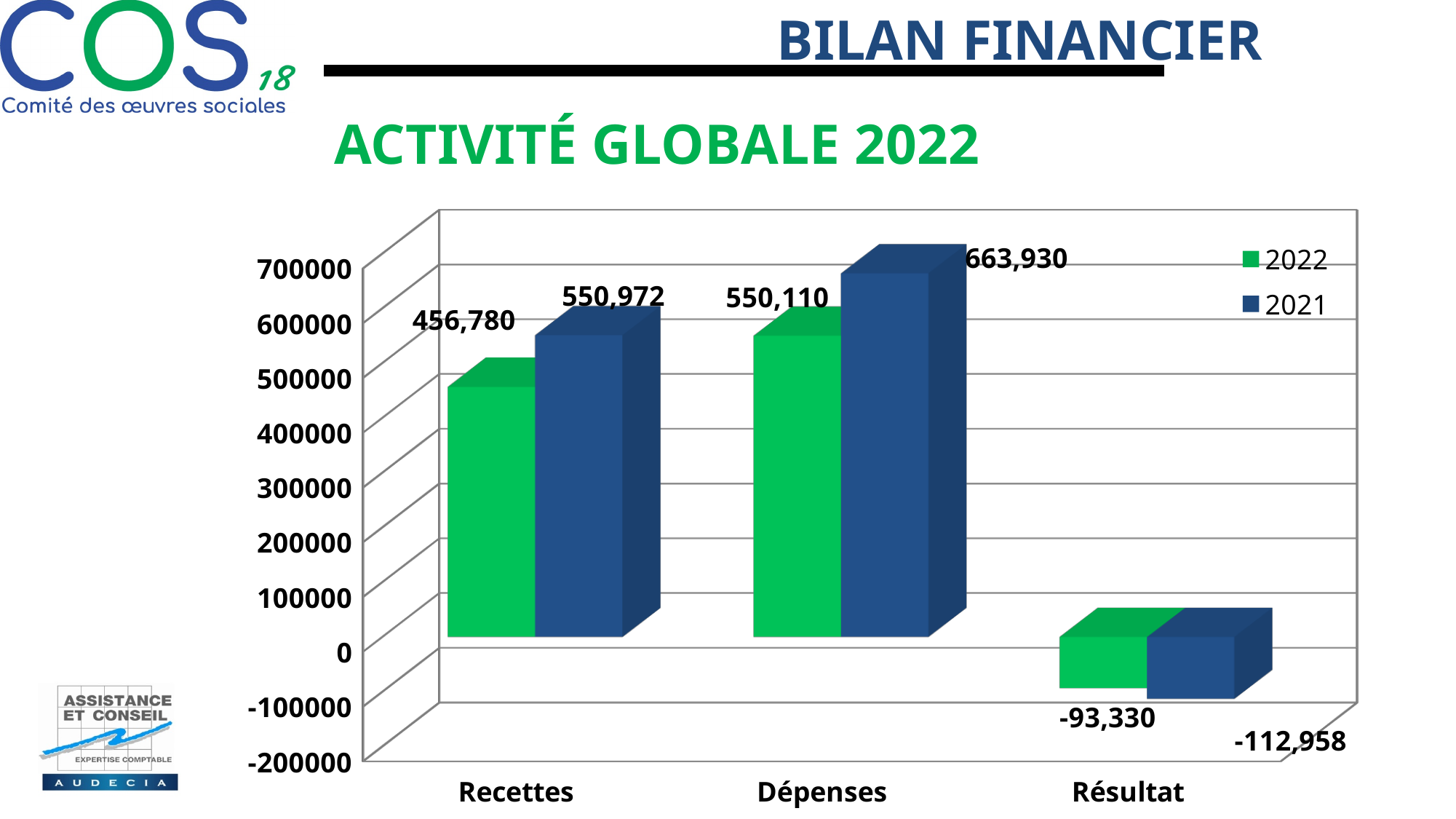
What is the value for Résultat in the 2021 series? -112,958 What is the difference between the 2021 and 2022 values for Recettes? 94,192 How many categories are shown on the x axis? 3 What is the value for Dépenses in the 2021 series? 663,930 What is the value for Recettes in the 2022 series? 456,780 Which category has the highest value in the 2021 series? Dépenses Which category has the lowest value in the 2022 series? Résultat What is the value for Résultat in the 2022 series? -93,330 Which is larger for Recettes: the 2022 value or the 2021 value? 2021 What is the difference between the 2021 and 2022 values for Dépenses? 113,820 How many series does the legend list? 2 What kind of chart is shown on the slide? Bar chart